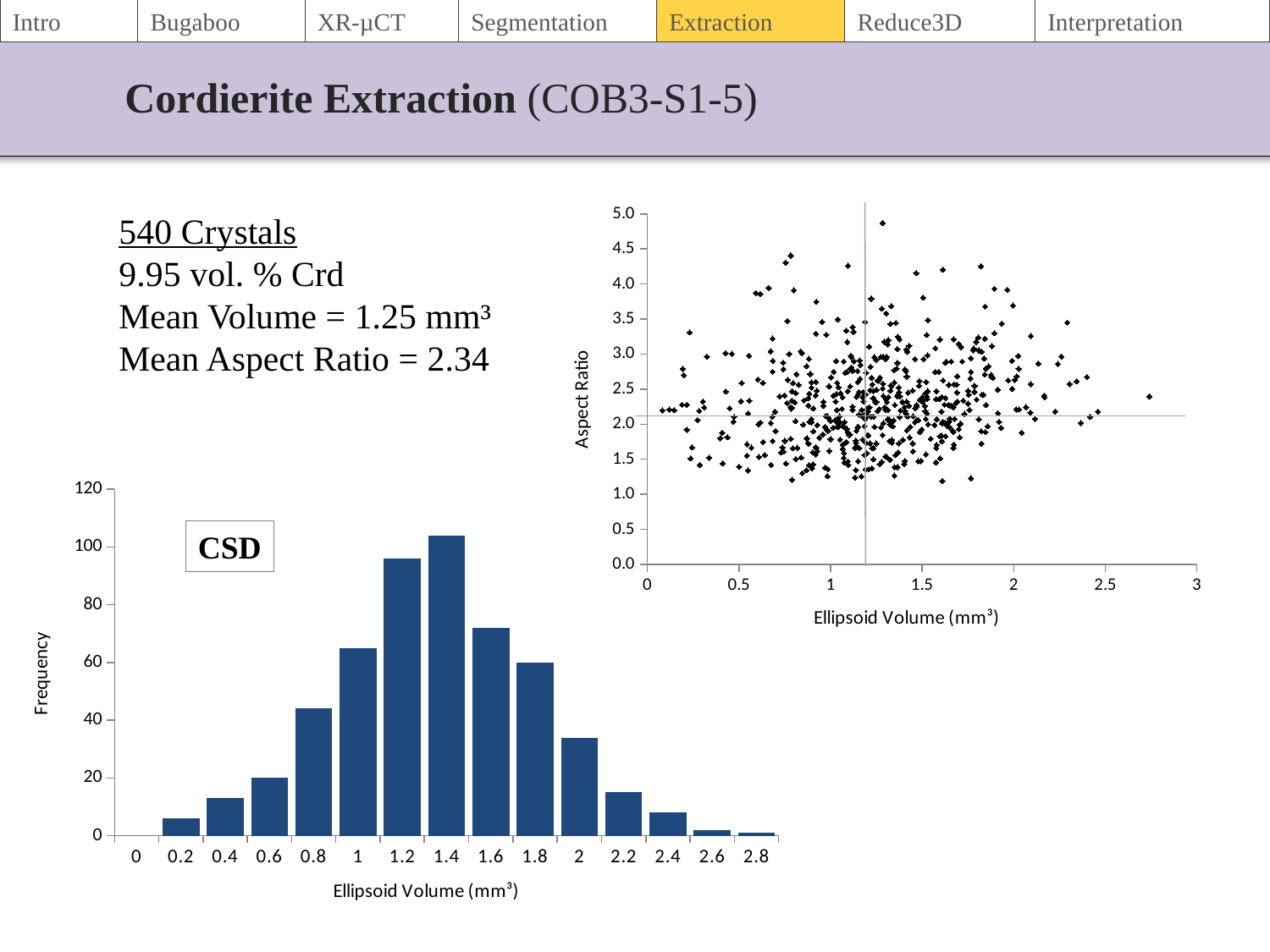
What is the y-axis label of the scatter plot at the top right of the slide? Aspect Ratio What kind of chart is the chart labelled CSD at the bottom left of the slide? bar chart In the CSD bar chart, which ellipsoid volume category has the highest frequency? 1.4 In the CSD bar chart, is the frequency for the 1.2 category greater or less than 100? less In the CSD bar chart, which has the higher frequency, the 1.2 category or the 1.6 category? 1.2 In the CSD bar chart, is the frequency for the 0.4 category greater or less than 20? less In the CSD bar chart, is the frequency for the 2 category greater or less than 40? less In the CSD bar chart, how many ellipsoid volume categories are labelled on the x axis? 15 In the CSD bar chart, which has the higher frequency, the 0.8 category or the 2 category? 0.8 What is the y-axis label of the CSD bar chart? Frequency What kind of chart is the chart at the top right of the slide? scatter plot